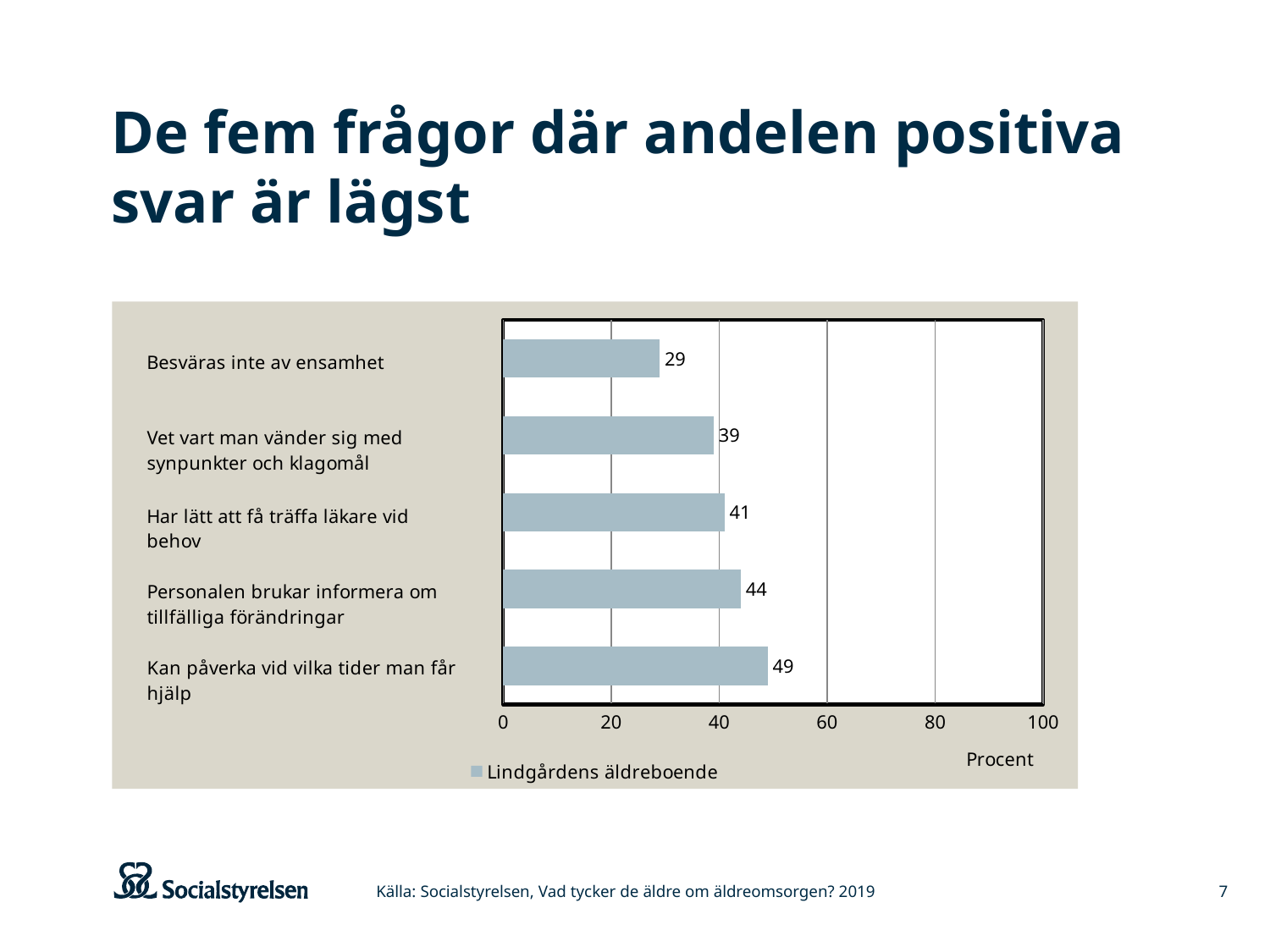
Which is larger: the value for "Vet vart man vänder sig med synpunkter och klagomål" or for "Personalen brukar informera om tillfälliga förändringar"? Personalen brukar informera om tillfälliga förändringar What is the difference between the values for "Kan påverka vid vilka tider man får hjälp" and "Besväras inte av ensamhet"? 20 What is the value for "Har lätt att få träffa läkare vid behov"? 41 What is the value for "Kan påverka vid vilka tider man får hjälp"? 49 What is the series name shown in the legend? Lindgårdens äldreboende How many series does the legend list? 1 How many categories are shown in the chart? 5 Is the value for "Vet vart man vänder sig med synpunkter och klagomål" greater or less than 40? less Which category has the highest value? Kan påverka vid vilka tider man får hjälp Which category has the lowest value? Besväras inte av ensamhet What kind of chart is shown on the slide? bar chart What is the value for "Besväras inte av ensamhet"? 29